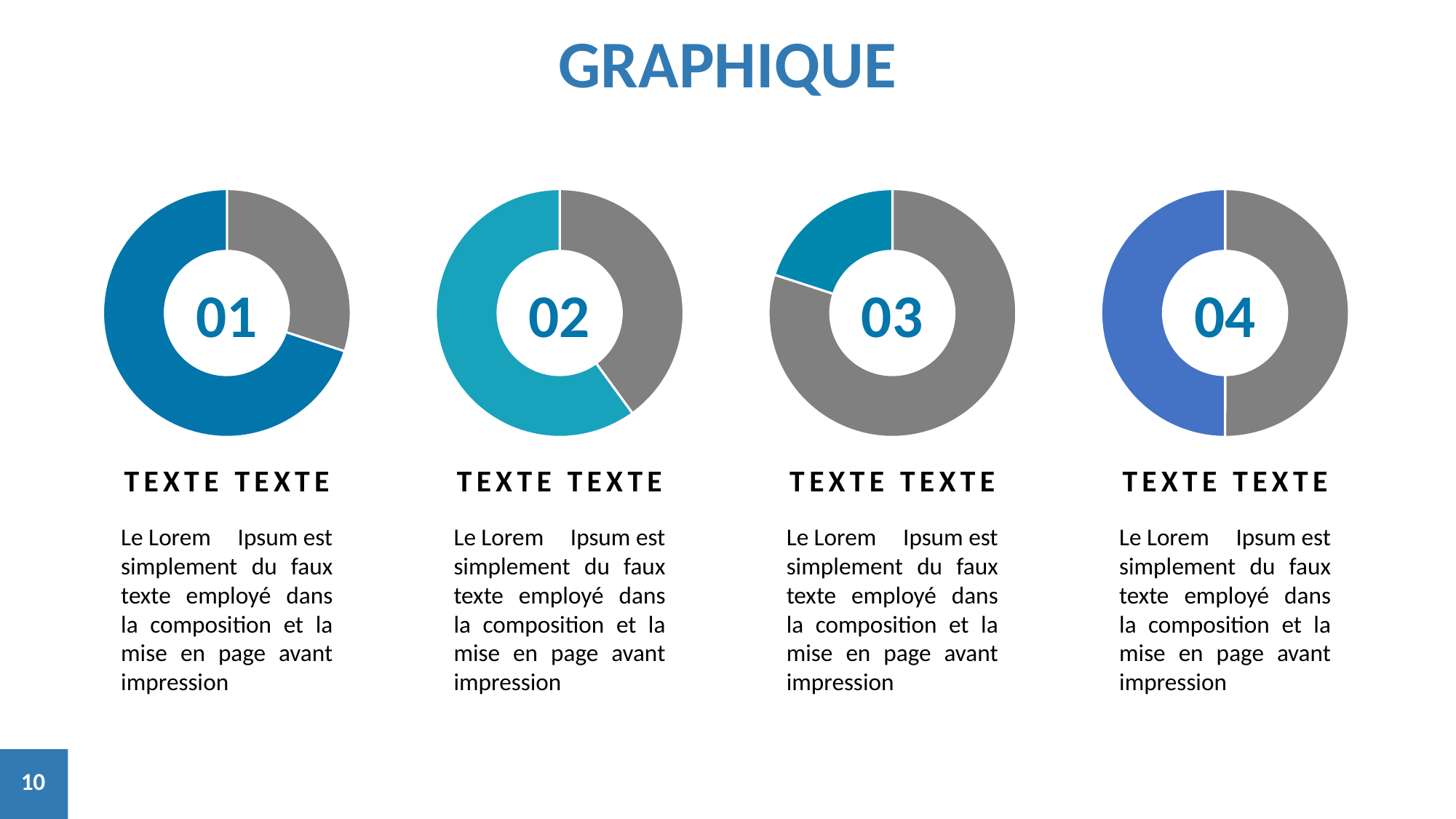
How many slices does the donut chart labelled 01 have? 2 In the donut chart labelled 02, which slice is larger, the teal slice or the grey slice? The teal slice Which of the four donut charts has the largest coloured (non-grey) slice? The chart labelled 01 In the donut chart labelled 03, which slice is larger, the blue slice or the grey slice? The grey slice What is the title of the slide containing the donut charts? GRAPHIQUE Which of the four donut charts has the smallest coloured (non-grey) slice? The chart labelled 03 What number is printed in the centre of the rightmost donut chart? 04 In the donut chart labelled 01, which slice is larger, the blue slice or the grey slice? The blue slice How many slices does the donut chart labelled 03 have? 2 How many donut charts are shown on the slide? 4 What kind of chart is the chart labelled 01 on the left of the slide? Donut chart